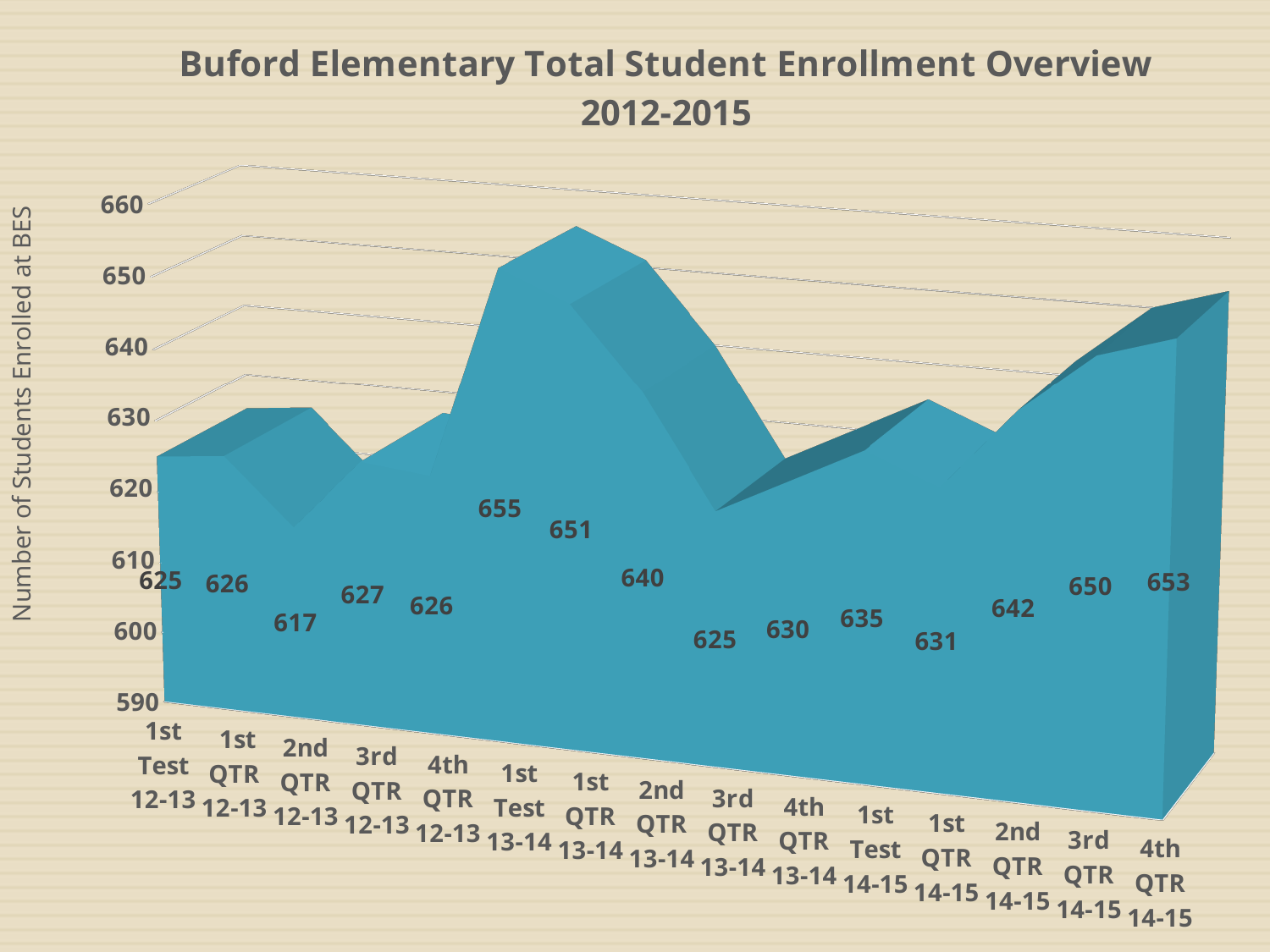
What is the difference in enrollment between 4th QTR 14-15 and 1st Test 12-13? 28 What is the enrollment value for 2nd QTR 14-15? 642 What kind of chart is shown on the slide? Area chart Which period has the lowest enrollment? 2nd QTR 12-13 Which period has the highest enrollment? 1st Test 13-14 How many periods are plotted on the chart? 15 What is the enrollment value for 4th QTR 14-15? 653 What is the enrollment value for 2nd QTR 12-13? 617 What is the label of the vertical axis? Number of Students Enrolled at BES Which has a higher enrollment, 1st QTR 13-14 or 3rd QTR 14-15? 1st QTR 13-14 What is the difference in enrollment between 1st Test 13-14 and 3rd QTR 13-14? 30 What is the enrollment value for 1st Test 13-14? 655